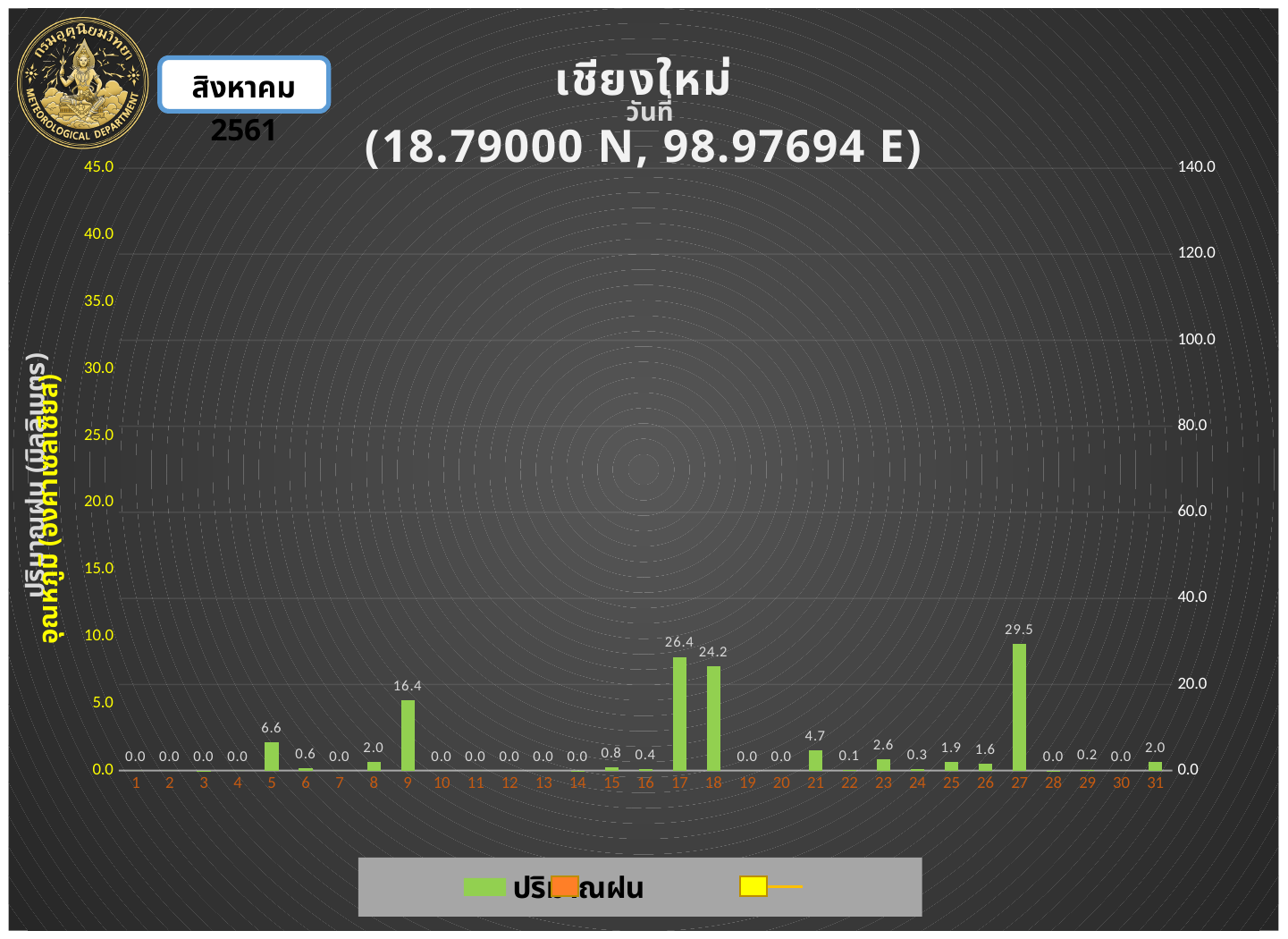
What is the rainfall value shown for day 5? 6.6 What is the rainfall value shown for day 21? 4.7 How many days are shown on the x axis? 31 What is the rainfall value shown for day 17? 26.4 What is the difference between the rainfall values for day 27 and day 9? 13.1 What coordinates are given in the chart title? 18.79000 N, 98.97694 E Which has a larger rainfall value, day 23 or day 25? day 23 What is the difference between the rainfall values for day 17 and day 18? 2.2 What is the rainfall value shown for day 9? 16.4 What kind of chart is shown on the slide? bar chart Which day has the highest rainfall value? 27 What is the rainfall value shown for day 27? 29.5